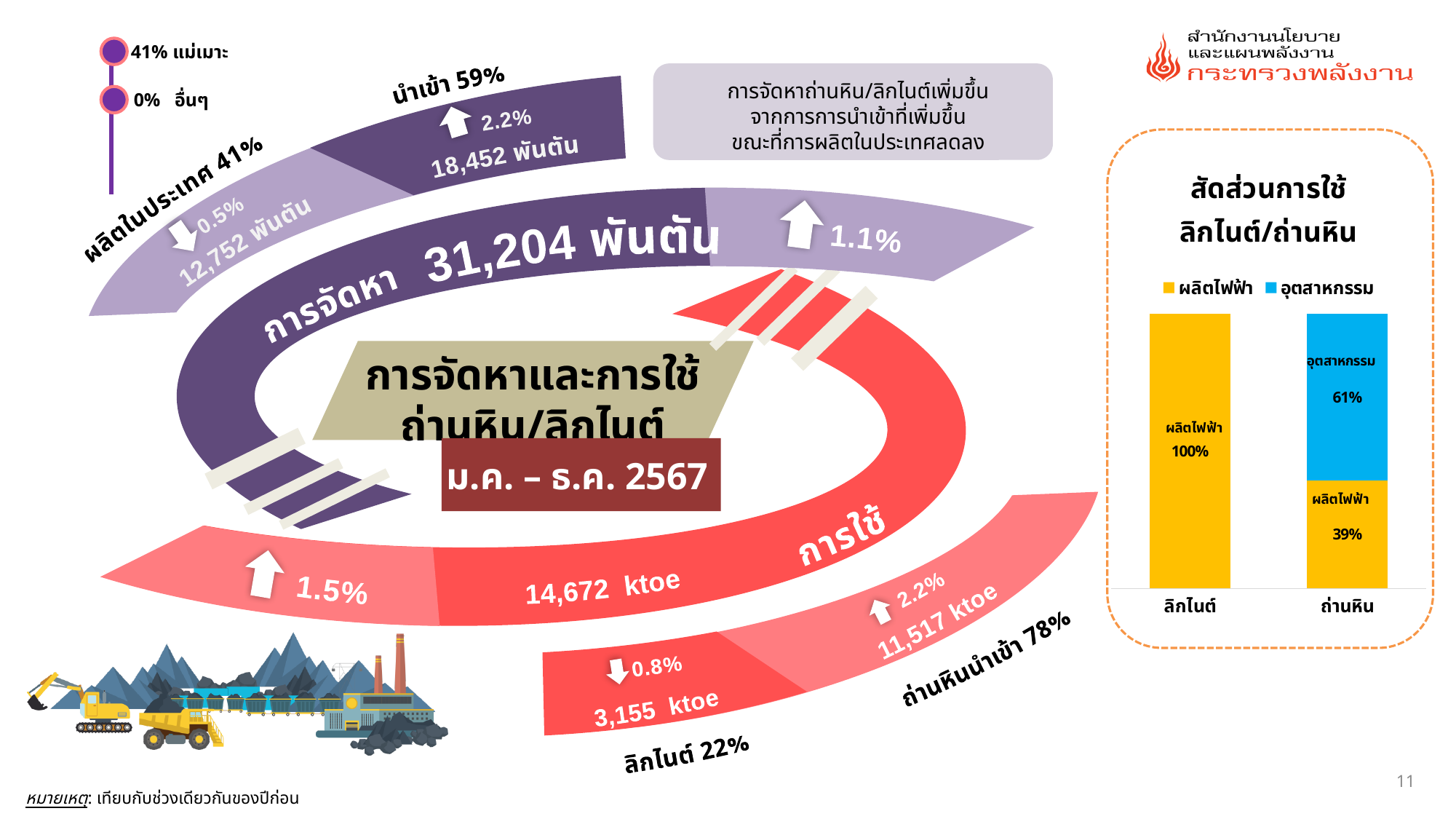
In the chart สัดส่วนการใช้ลิกไนต์/ถ่านหิน, which is larger for ถ่านหิน: อุตสาหกรรม or ผลิตไฟฟ้า? อุตสาหกรรม In the chart สัดส่วนการใช้ลิกไนต์/ถ่านหิน, which category has the higher ผลิตไฟฟ้า share? ลิกไนต์ In the chart สัดส่วนการใช้ลิกไนต์/ถ่านหิน, what is the value of ผลิตไฟฟ้า for ลิกไนต์? 100% In the chart สัดส่วนการใช้ลิกไนต์/ถ่านหิน, what is the total of the stacked bar for ถ่านหิน? 100% In the chart สัดส่วนการใช้ลิกไนต์/ถ่านหิน, how many series does the legend list? 2 In the chart สัดส่วนการใช้ลิกไนต์/ถ่านหิน, what is the value of ผลิตไฟฟ้า for ถ่านหิน? 39% What kind of chart is shown in the box titled สัดส่วนการใช้ลิกไนต์/ถ่านหิน? Stacked bar chart In the chart สัดส่วนการใช้ลิกไนต์/ถ่านหิน, how many categories are shown on the x axis? 2 In the chart สัดส่วนการใช้ลิกไนต์/ถ่านหิน, what colour represents ผลิตไฟฟ้า? Yellow In the chart สัดส่วนการใช้ลิกไนต์/ถ่านหิน, what is the difference between the อุตสาหกรรม and ผลิตไฟฟ้า shares for ถ่านหิน? 22% In the chart สัดส่วนการใช้ลิกไนต์/ถ่านหิน, what colour represents อุตสาหกรรม? Blue In the chart สัดส่วนการใช้ลิกไนต์/ถ่านหิน, what is the value of อุตสาหกรรม for ถ่านหิน? 61%